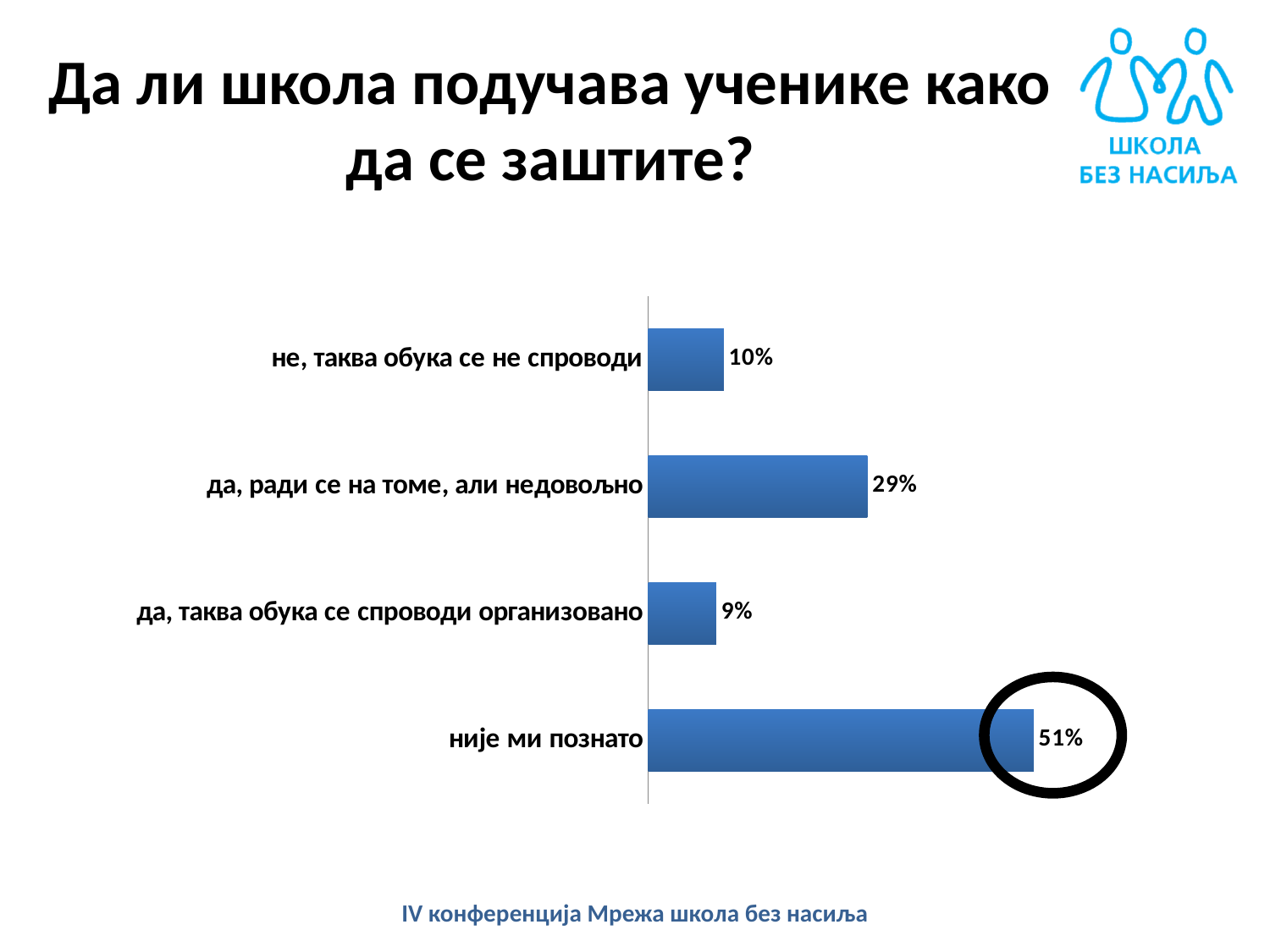
What is the value for "није ми познато"? 51% What is the difference between the values for "не, таква обука се не спроводи" and "да, таква обука се спроводи организовано"? 1% What is the difference between the values for "није ми познато" and "да, ради се на томе, али недовољно"? 22% Which bar on the chart is circled? није ми познато Which category has the highest value? није ми познато What kind of chart is shown on the slide? bar chart What is the value for "не, таква обука се не спроводи"? 10% Which category has the lowest value? да, таква обука се спроводи организовано How many categories are shown in the chart? 4 Which is larger: the value for "да, ради се на томе, али недовољно" or the value for "не, таква обука се не спроводи"? да, ради се на томе, али недовољно What is the value for "да, таква обука се спроводи организовано"? 9% What is the value for "да, ради се на томе, али недовољно"? 29%